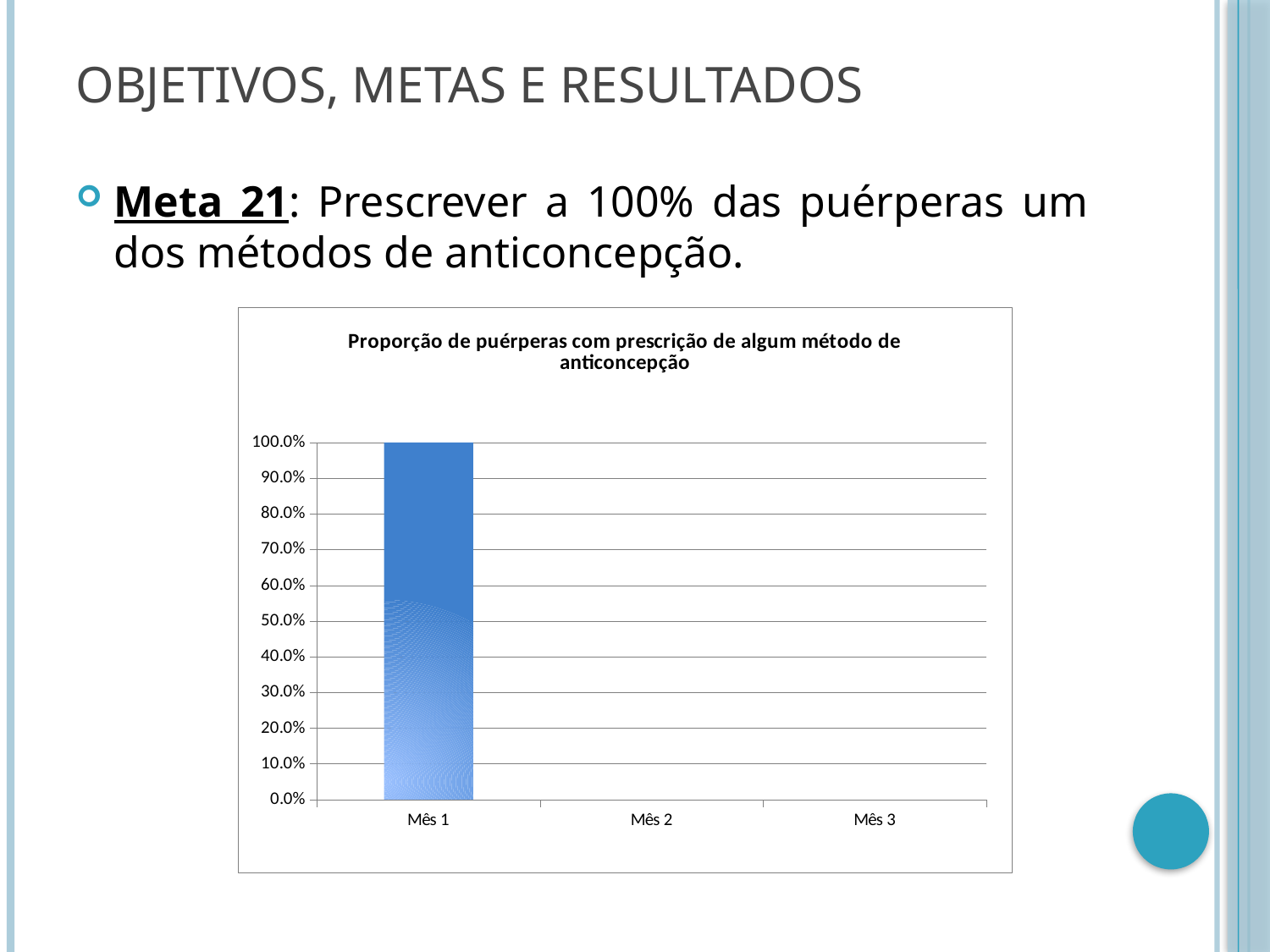
What is the title of the chart? Proporção de puérperas com prescrição de algum método de anticoncepção What is the value for Mês 1 in the chart? 100.0% How many categories in the chart have a visible bar? 1 How many categories are shown on the x axis of the chart? 3 Is the value for Mês 1 greater or less than 50.0%? greater What kind of chart is shown on the slide? bar chart Which is larger, the value for Mês 1 or the value for Mês 2? Mês 1 Which categories in the chart show no bar? Mês 2 and Mês 3 What is the highest value labelled on the y axis of the chart? 100.0% Which category has the highest value in the chart? Mês 1